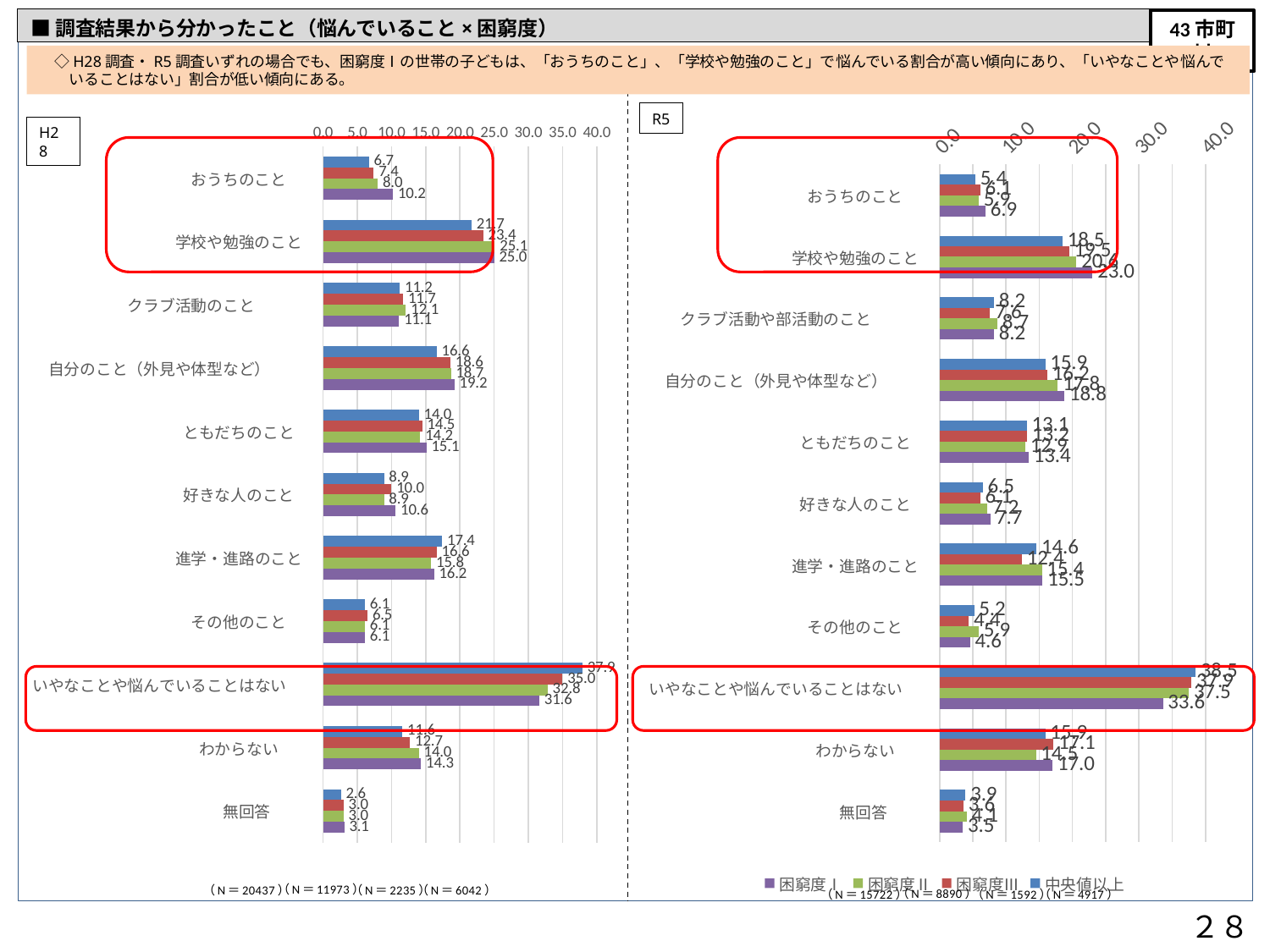
In the H28 chart, what is the difference between the 困窮度Ⅰ value and the 中央値以上 value for おうちのこと? 3.5 In the H28 chart, which category has the highest value for 困窮度Ⅰ? いやなことや悩んでいることはない In the H28 chart, which category has the lowest value for 困窮度Ⅰ? 無回答 In the H28 chart, what is the value for 中央値以上 for 学校や勉強のこと? 21.7 In the H28 chart, what is the value for 困窮度Ⅰ for おうちのこと? 10.2 How many series does the legend on the R5 chart list? 4 In the R5 chart, what is the value for 困窮度Ⅰ for いやなことや悩んでいることはない? 33.6 In the R5 chart, what is the value for 困窮度Ⅰ for 学校や勉強のこと? 23.0 In the R5 chart, which is larger for 自分のこと（外見や体型など）: the 困窮度Ⅰ value or the 中央値以上 value? 困窮度Ⅰ How many categories are shown on the H28 chart? 11 In the R5 chart, is the 困窮度Ⅰ value for いやなことや悩んでいることはない greater or less than 30.0? greater What kind of chart is the H28 chart on the left? Bar chart